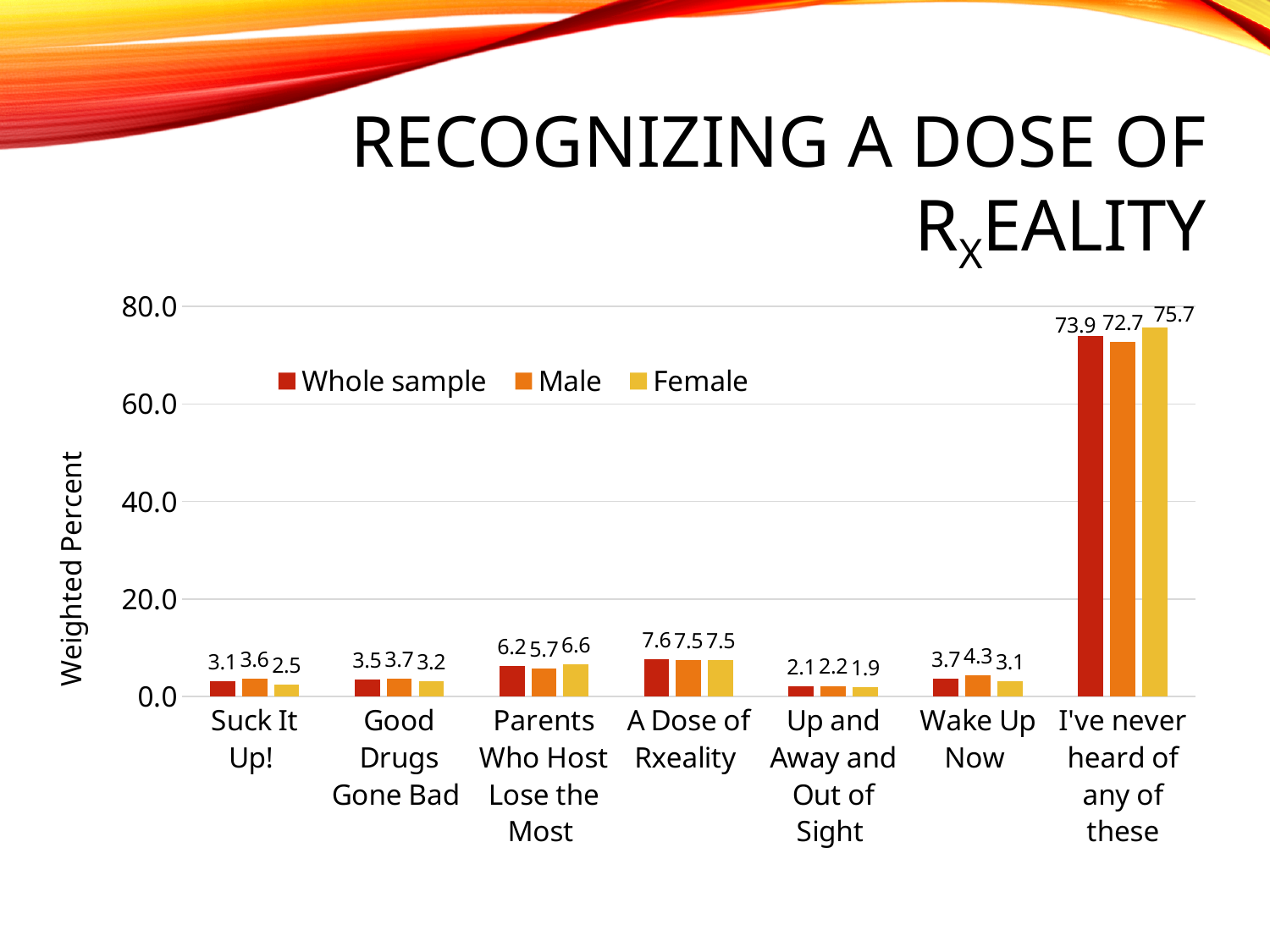
Which is larger for "Suck It Up!": the Male value or the Female value? Male What is the label of the y axis? Weighted Percent How many categories are shown on the x axis? 7 What is the Whole sample value for "I've never heard of any of these"? 73.9 What kind of chart is shown on the slide? bar chart Is the Whole sample value for "A Dose of Rxeality" greater or less than 20.0? less How many series does the legend list? 3 What is the Male value for "Wake Up Now"? 4.3 Which category has the highest Whole sample value? I've never heard of any of these What is the difference between the Female and Male values for "I've never heard of any of these"? 3.0 Which category has the lowest Female value? Up and Away and Out of Sight What is the Female value for "Parents Who Host Lose the Most"? 6.6